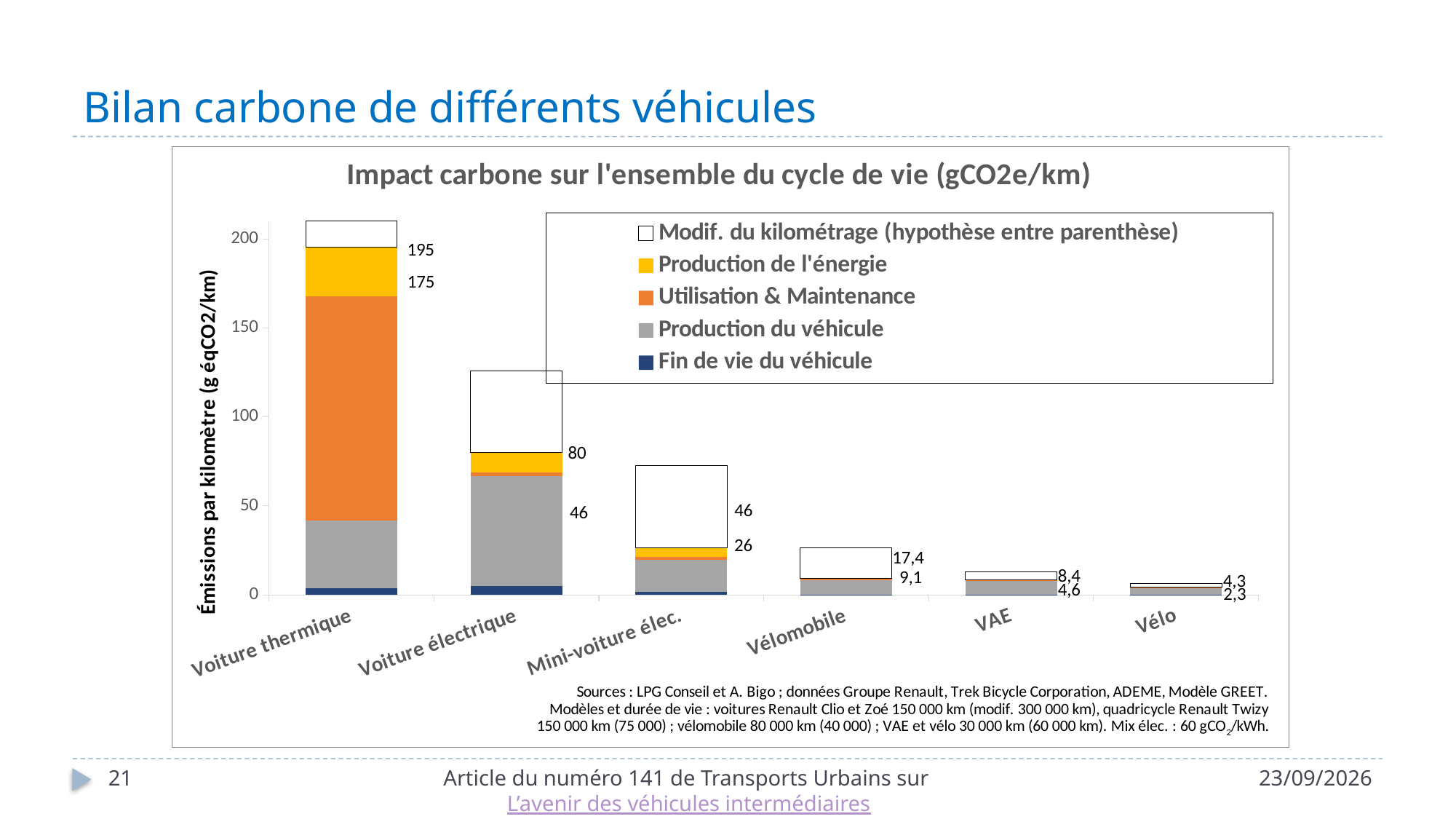
How many vehicle categories are shown on the x axis? 6 What type of chart is shown on the slide? Stacked bar chart What is the smaller of the two values labelled next to the Vélomobile bar? 9,1 How many series does the legend list? 5 Which vehicle category has the lowest bar? Vélo What is the larger of the two values labelled next to the Voiture électrique bar? 80 What is the larger of the two values labelled next to the Voiture thermique bar? 195 Do the bar heights rise or fall from left to right along the x axis? Fall What is the difference between the two values labelled for Voiture thermique (195 and 175)? 20 What two values are labelled next to the Vélo bar? 4,3 and 2,3 Which vehicle category has the highest bar? Voiture thermique Is the top of the Voiture électrique bar (including the white segment) greater or less than 100? greater